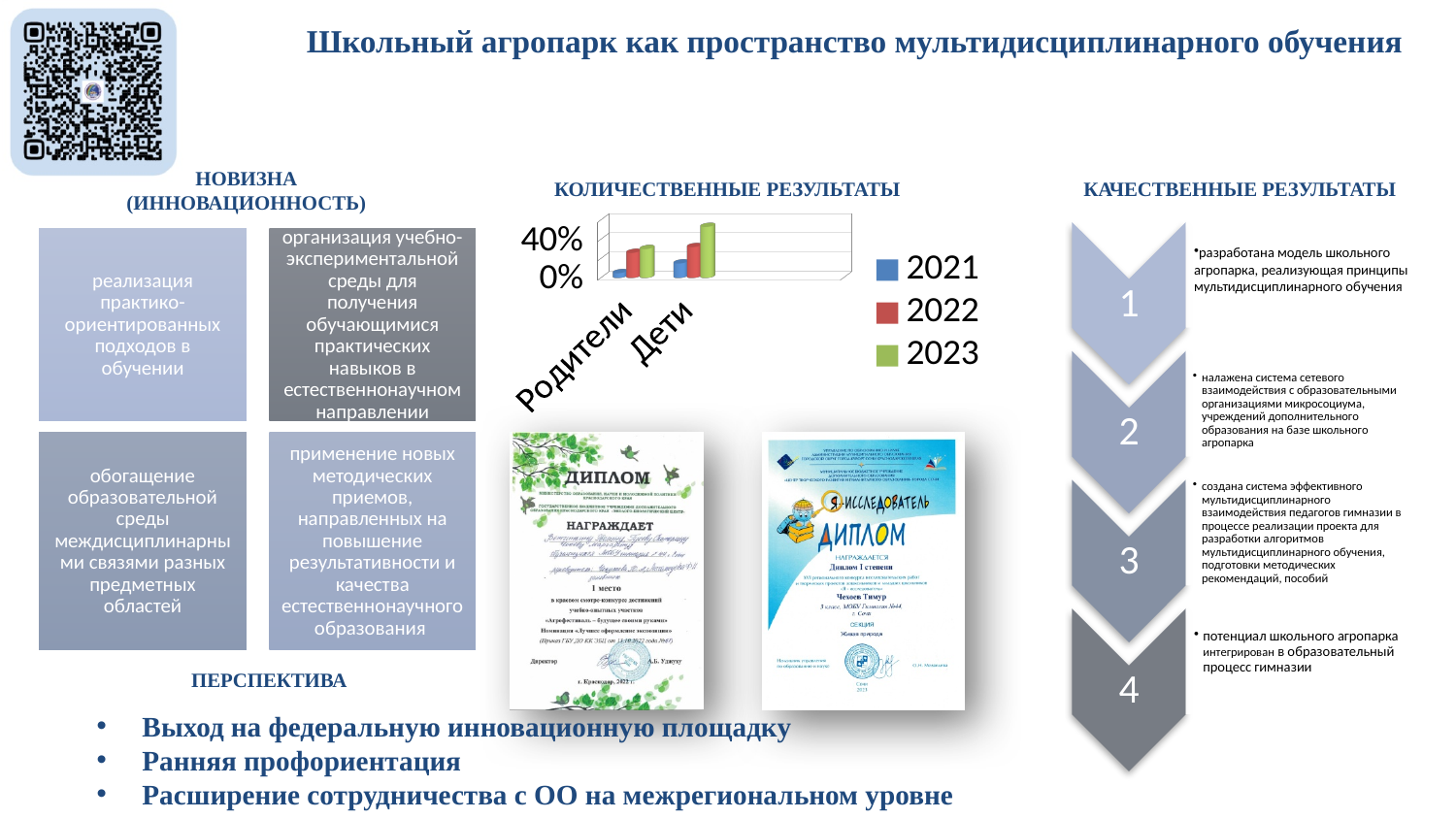
For the category «Дети», which year has the highest bar? 2023 What are the two categories on the x axis of the bar chart? Родители, Дети How many series does the legend of the bar chart list? 3 Do the values for «Дети» rise or fall from 2021 to 2023? rise For the category «Родители», which year has the highest bar? 2023 Is the value for «Родители» in 2021 greater or less than 40%? less How many categories are shown on the x axis of the bar chart? 2 For the category «Родители», which year has the lowest bar? 2021 What kind of chart is shown under the heading «КОЛИЧЕСТВЕННЫЕ РЕЗУЛЬТАТЫ»? bar chart For «Дети», is the bar for 2023 larger or smaller than the bar for 2021? larger Which years are listed in the legend of the bar chart? 2021, 2022, 2023 For the category «Дети», which year has the lowest bar? 2021